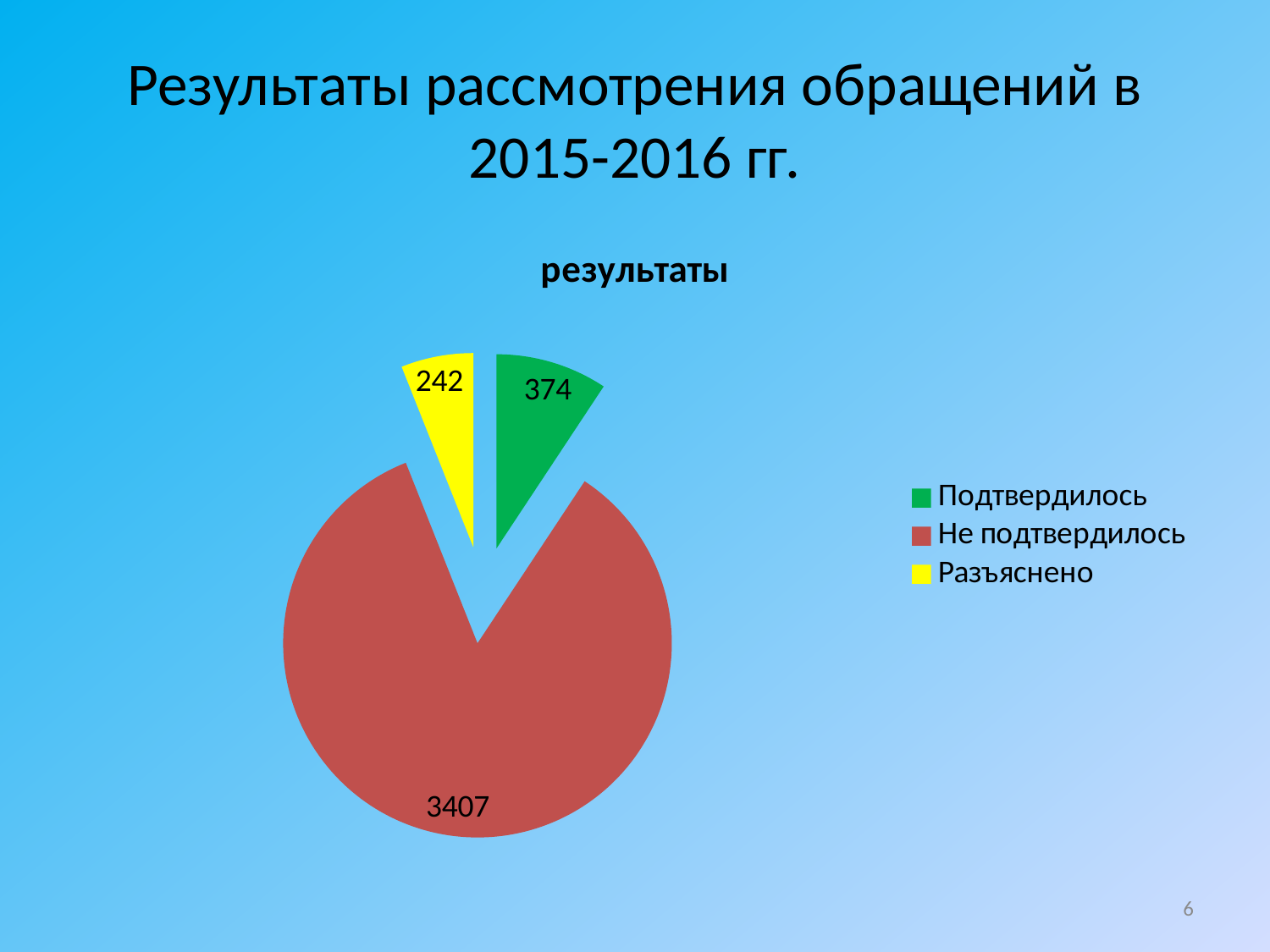
Which category has the smallest slice in the pie chart? Разъяснено How many slices does the pie chart have? 3 What is the difference between the values for Не подтвердилось and Подтвердилось? 3033 What value is shown for Разъяснено in the pie chart? 242 What is the total of all values in the pie chart? 4023 What value is shown for Не подтвердилось in the pie chart? 3407 What is the title of the chart on the slide? результаты Which is larger, the value for Подтвердилось or the value for Разъяснено? Подтвердилось What value is shown for Подтвердилось in the pie chart? 374 What kind of chart is shown on the slide? Pie chart Which category has the largest slice in the pie chart? Не подтвердилось What is the difference between the values for Подтвердилось and Разъяснено? 132